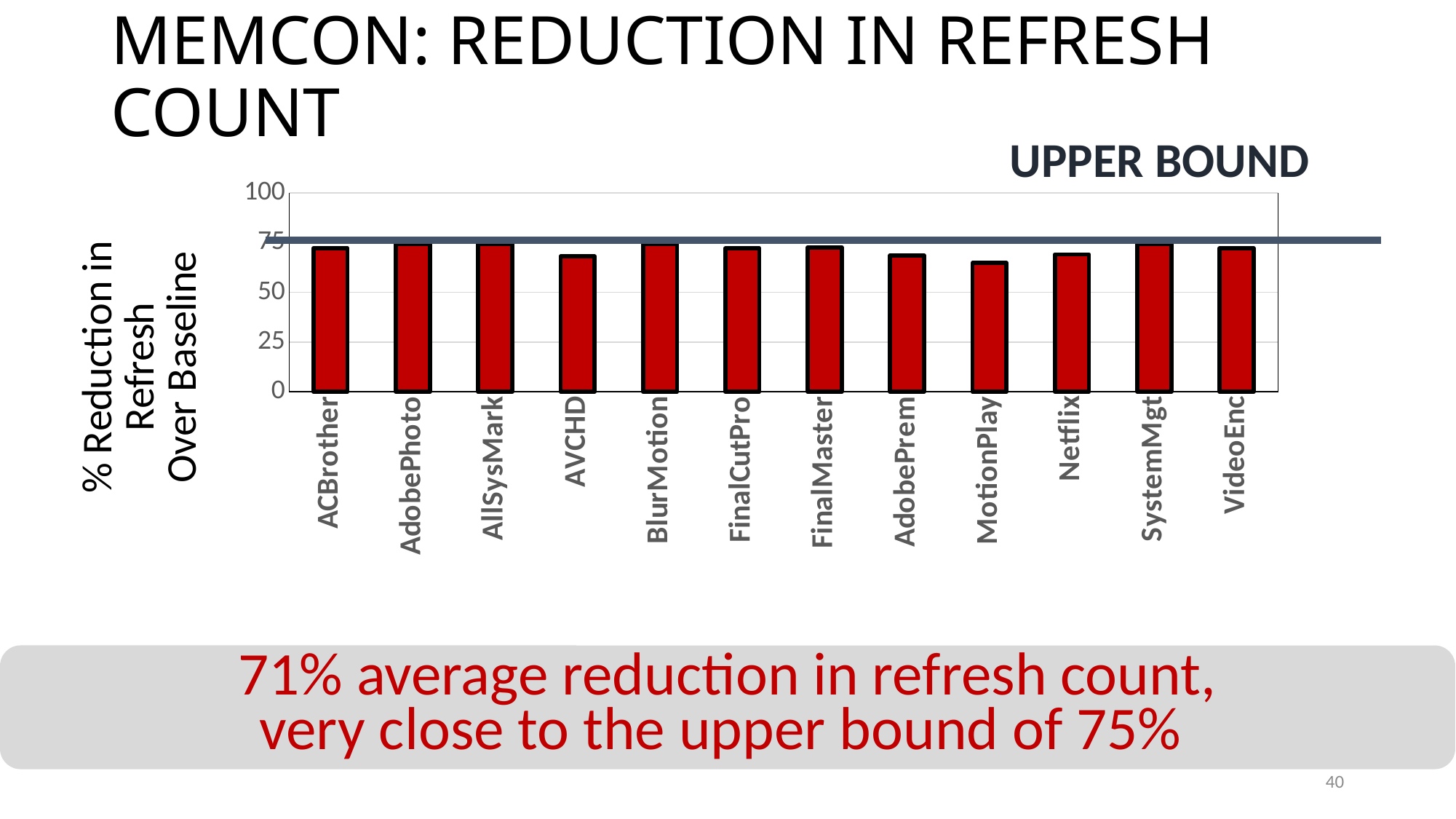
What is the label of the y axis? % Reduction in Refresh Over Baseline Which is larger, the value for AVCHD or the value for BlurMotion? BlurMotion What does the horizontal line drawn across the chart at 75 represent? UPPER BOUND Which workload has the lowest % reduction in refresh over baseline? MotionPlay Which is larger, the value for AdobePhoto or the value for MotionPlay? AdobePhoto Is the value for AVCHD greater or less than 75? less Is the value for MotionPlay greater or less than 50? greater Do any of the bars exceed the upper bound line at 75? No How many workloads (categories) are plotted on the x axis? 12 What kind of chart is shown on the slide? bar chart